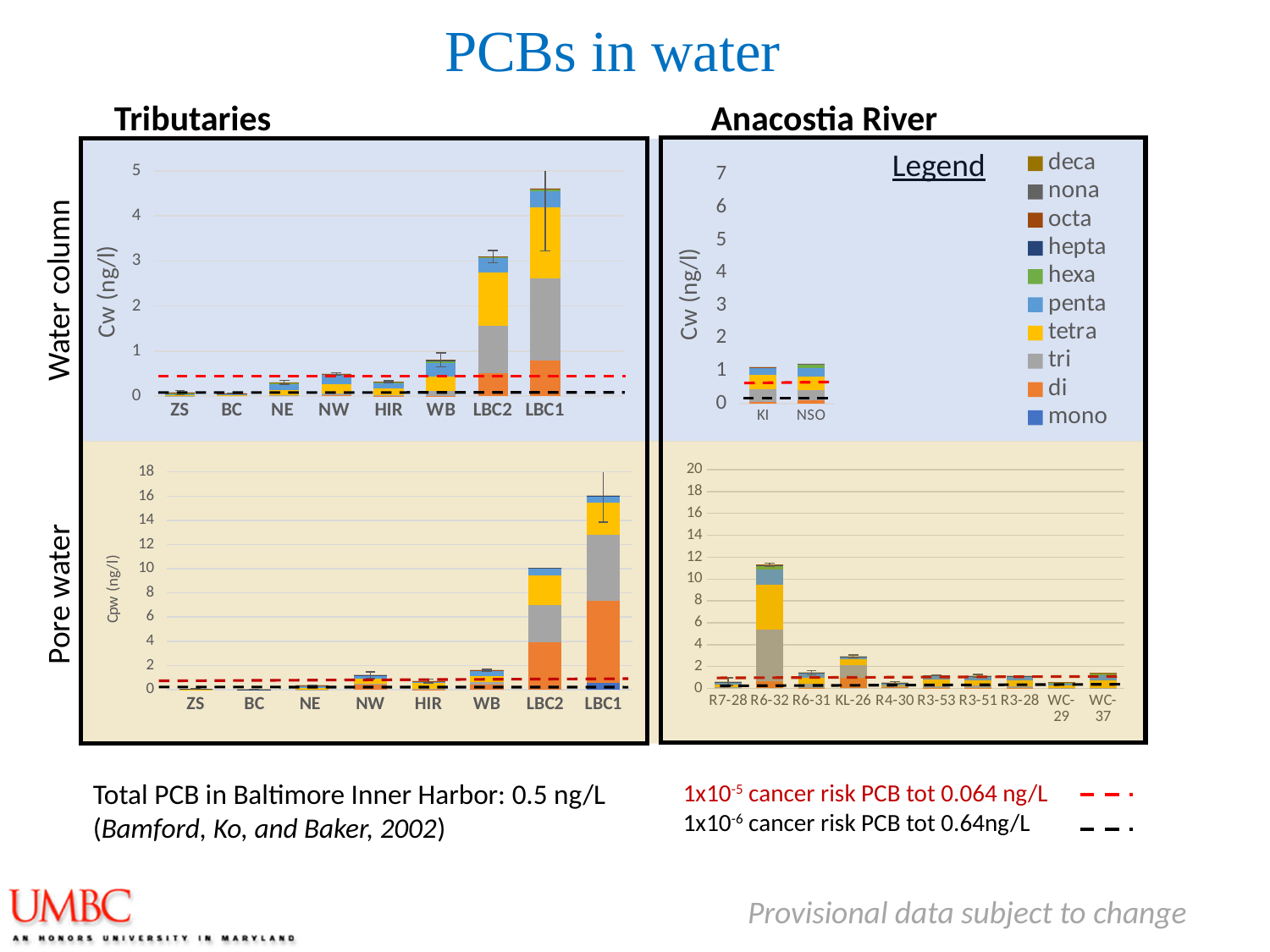
In the Tributaries pore water chart (bottom left), which category has the highest total bar? LBC1 In the Anacostia River pore water chart (bottom right), is the total value for R6-32 greater or less than 10? greater How many categories are shown on the x axis of the Anacostia River water column chart (top right)? 2 In the Anacostia River pore water chart (bottom right), which category has the highest total bar? R6-32 How many categories are shown on the x axis of the Tributaries water column chart (top left)? 8 In the Tributaries water column chart (top left), which is larger, the total for LBC1 or the total for LBC2? LBC1 In the Tributaries water column chart (top left), is the total value for WB greater or less than 1? less How many series does the legend on the slide list? 10 How many categories are shown on the x axis of the Anacostia River pore water chart (bottom right)? 10 In the Tributaries water column chart (top left), is the total value for LBC1 greater or less than 4? greater In the Tributaries water column chart (top left), which category has the highest total bar? LBC1